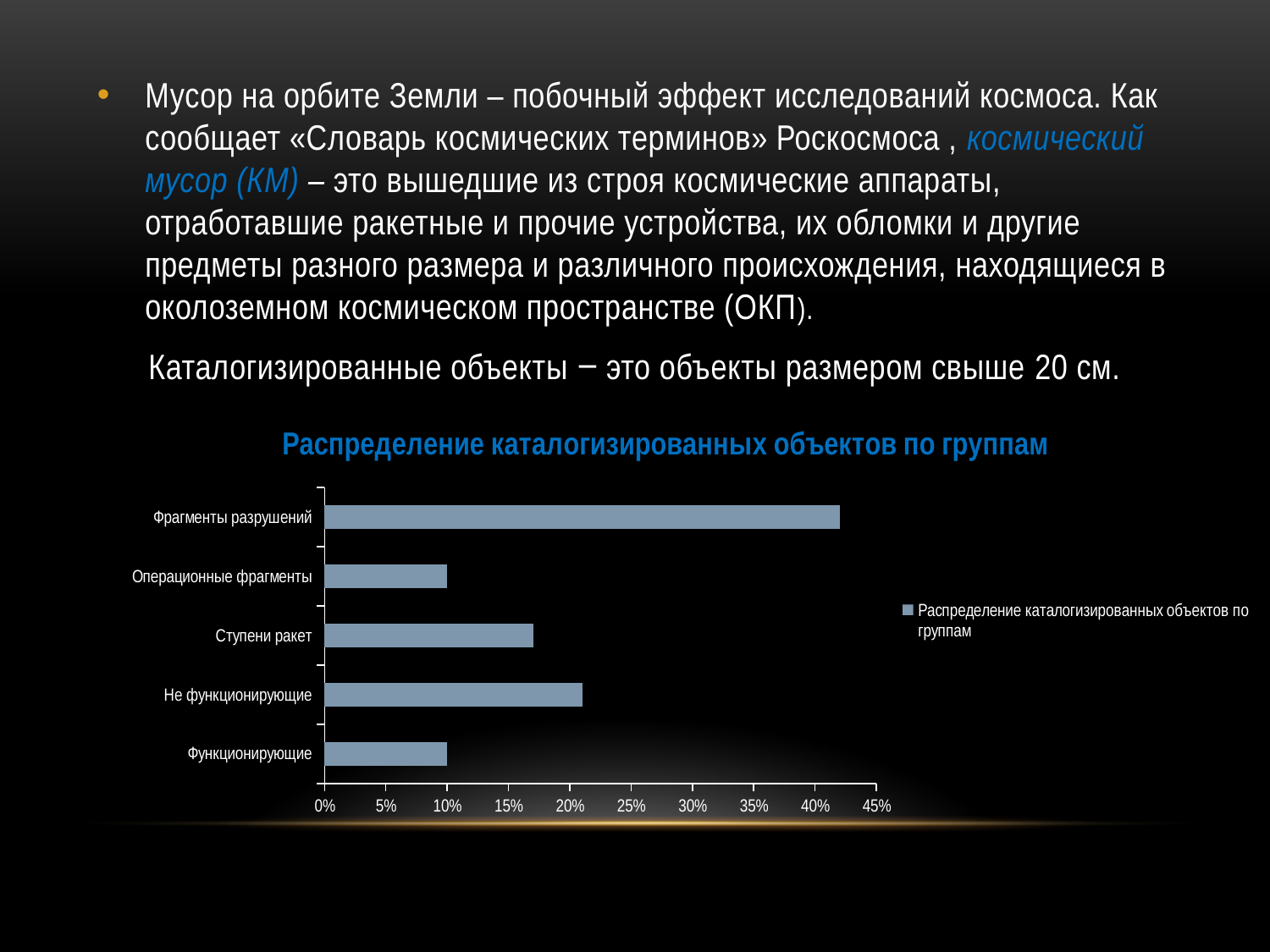
Is the value for Не функционирующие greater or less than 20%? greater What is the value for Операционные фрагменты? 10% Which category has the highest value in the chart? Фрагменты разрушений Is the value for Ступени ракет greater or less than 15%? greater What type of chart is shown on the slide? Bar chart How many series does the legend list? 1 Which is larger, the value for Не функционирующие or the value for Ступени ракет? Не функционирующие Which is larger, the value for Фрагменты разрушений or the value for Не функционирующие? Фрагменты разрушений How many categories are shown in the chart? 5 What is the title of the chart? Распределение каталогизированных объектов по группам Is the value for Фрагменты разрушений greater or less than 40%? greater What is the value for Функционирующие? 10%